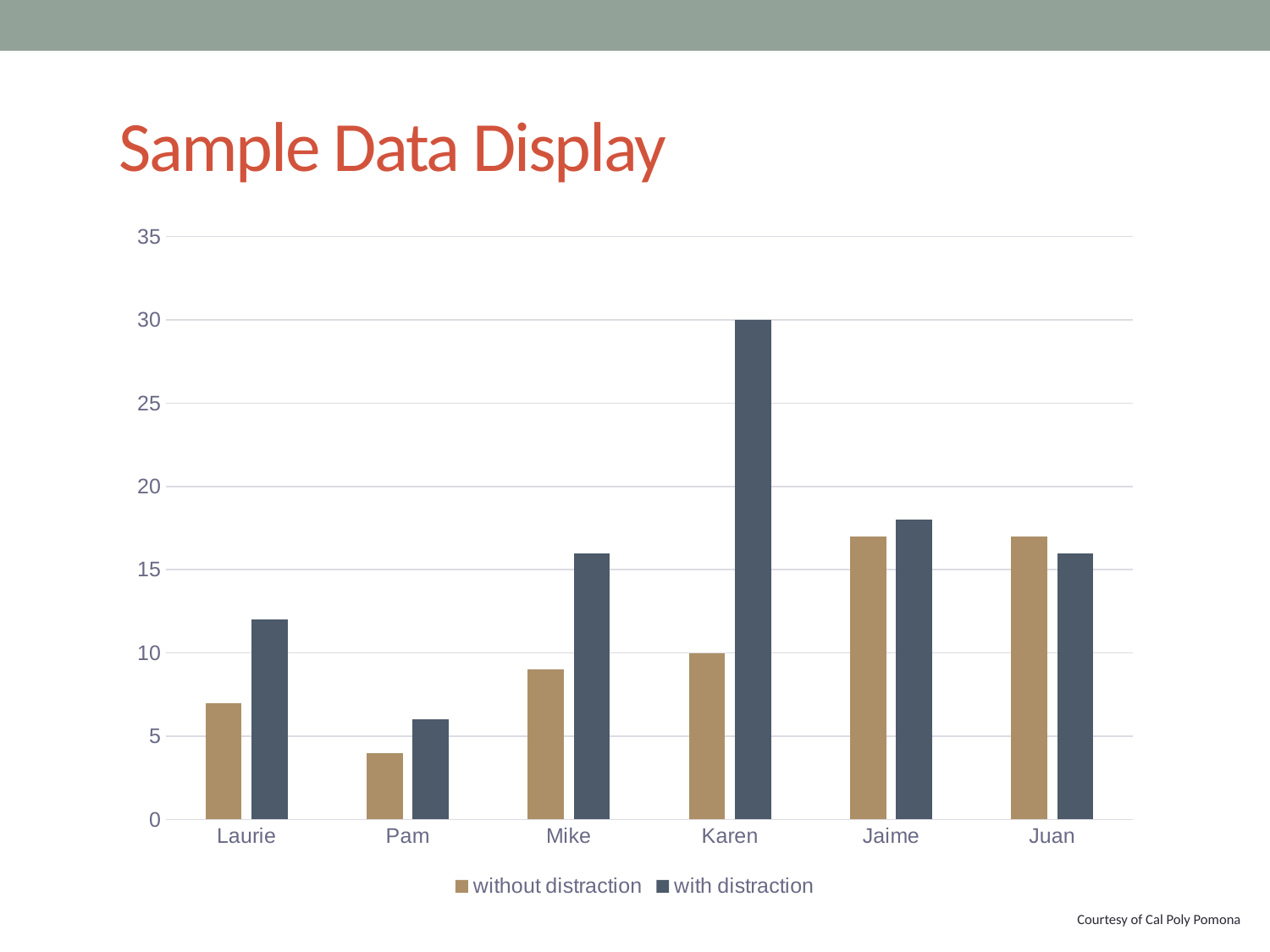
Which person has the highest value in the 'with distraction' series? Karen What is the value for Karen in the 'without distraction' series? 10 What is the value for Karen in the 'with distraction' series? 30 Is the 'with distraction' value for Mike greater or less than 15? greater What is the difference between Karen's 'with distraction' and 'without distraction' values? 20 Which person has the lowest value in the 'without distraction' series? Pam Is the 'without distraction' value for Pam greater or less than 5? less Which person has the lowest value in the 'with distraction' series? Pam What type of chart is shown on the slide? bar chart For Laurie, which is larger: the 'without distraction' value or the 'with distraction' value? with distraction How many people (categories) are shown on the x axis? 6 How many series does the legend list? 2